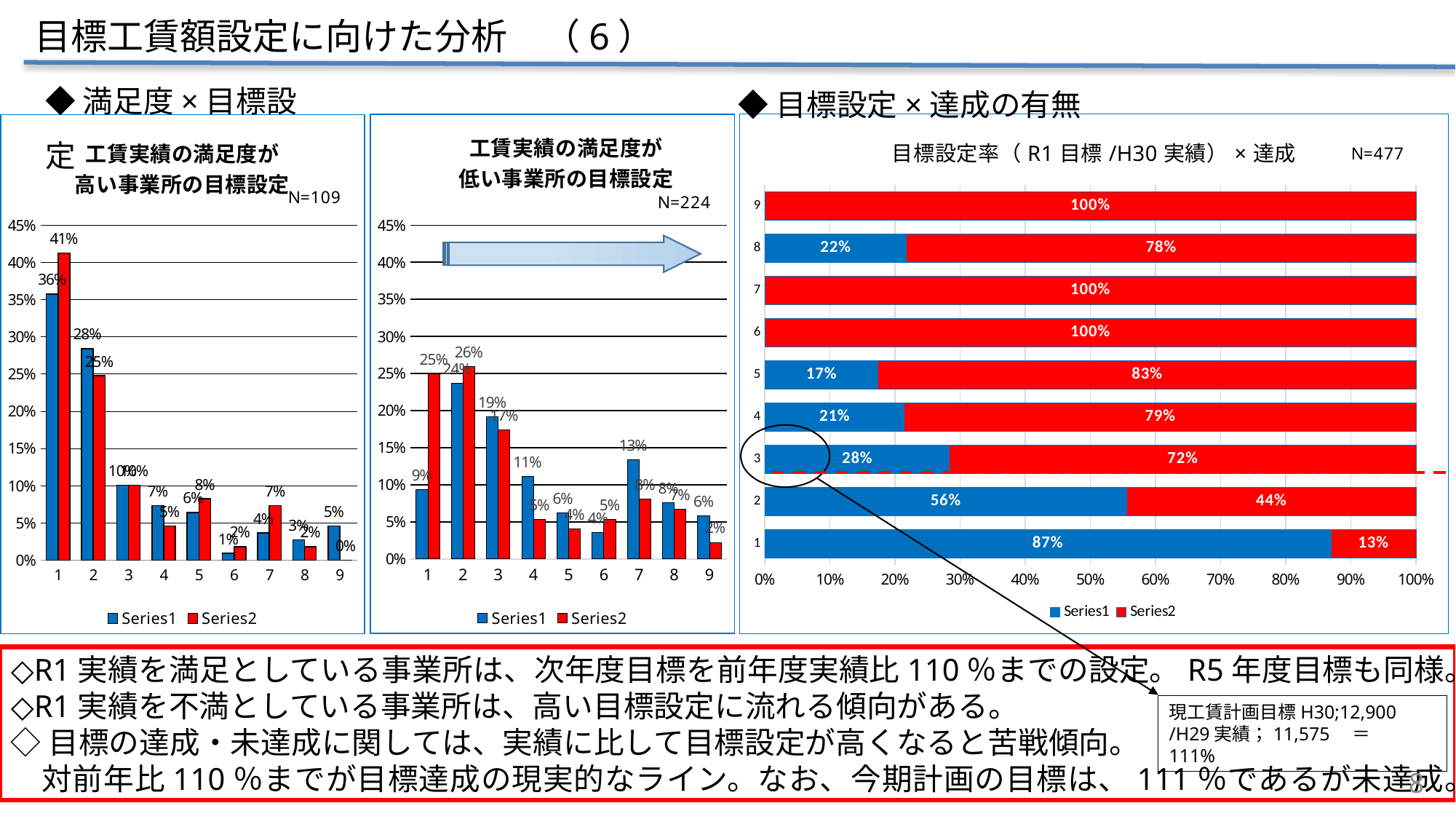
In the middle chart (工賃実績の満足度が低い事業所の目標設定), which category has the highest Series2 value? 2 In the middle chart (工賃実績の満足度が低い事業所の目標設定), which is larger for category 1: Series1 or Series2? Series2 In the left chart (工賃実績の満足度が高い事業所の目標設定), what is the difference between the Series1 and Series2 values for category 2? 3% What type of chart is the right chart (目標設定率（R1目標/H30実績）×達成)? Stacked bar chart How many series does the legend of the left chart (工賃実績の満足度が高い事業所の目標設定) list? 2 In the left chart (工賃実績の満足度が高い事業所の目標設定), which category has the highest Series1 value? 1 In the left chart (工賃実績の満足度が高い事業所の目標設定), what is the Series2 value for category 1? 41% In the middle chart (工賃実績の満足度が低い事業所の目標設定), what is the Series1 value for category 7? 13% In the right chart (目標設定率（R1目標/H30実績）×達成), which category has the highest Series1 value? 1 In the right chart (目標設定率（R1目標/H30実績）×達成), what is the Series1 value for category 2? 56% In the middle chart (工賃実績の満足度が低い事業所の目標設定), how many categories are shown on the x axis? 9 In the right chart (目標設定率（R1目標/H30実績）×達成), what is the Series2 value for category 5? 83%